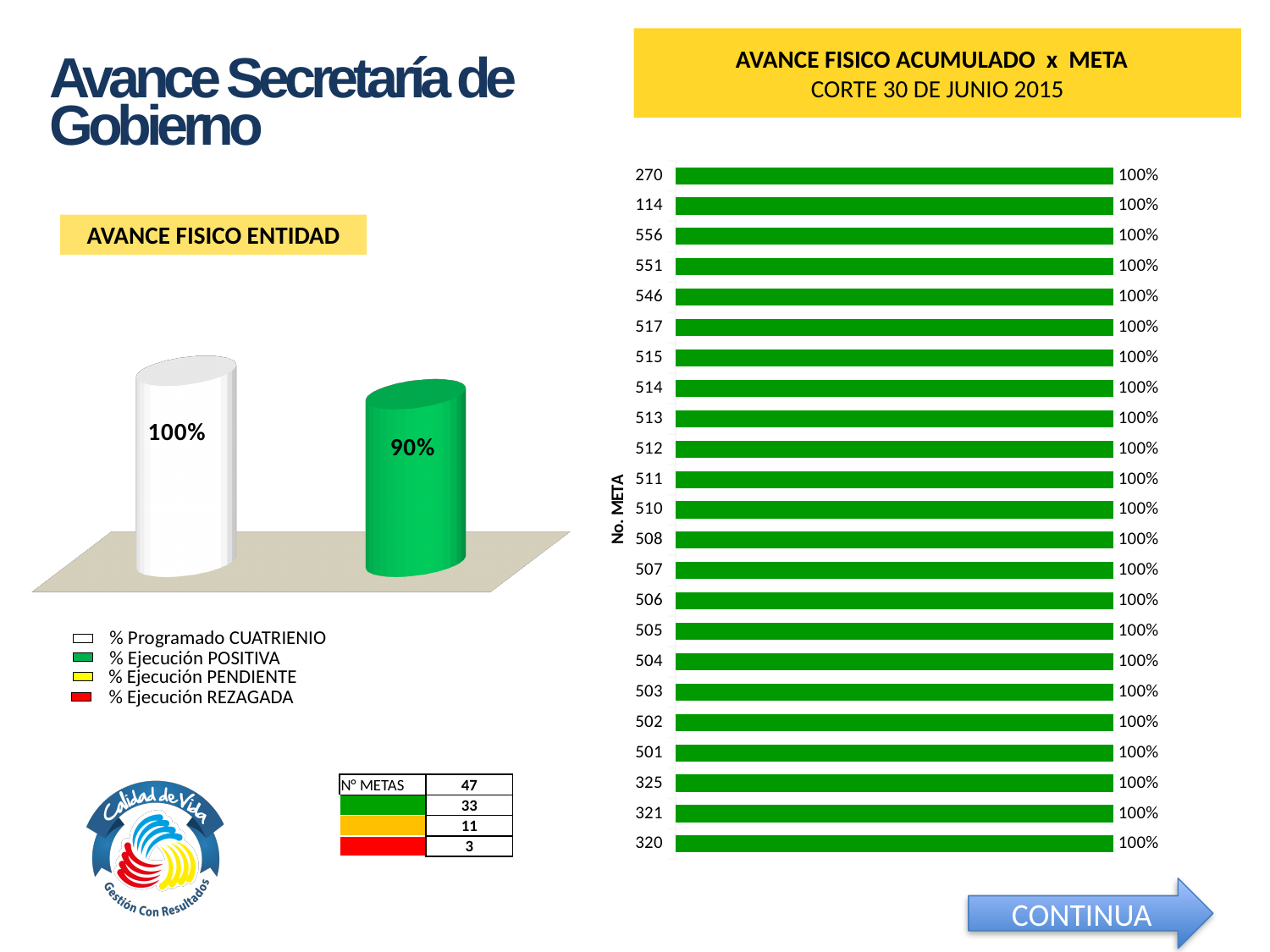
How many entries does the legend of the AVANCE FISICO ENTIDAD chart list? 4 In the AVANCE FISICO ENTIDAD chart, what is the value for % Ejecución POSITIVA? 90% What is the label of the vertical axis in the AVANCE FISICO ACUMULADO x META chart? No. META What kind of chart is the AVANCE FISICO ACUMULADO x META chart? Bar chart In the AVANCE FISICO ENTIDAD chart, what colour is the bar for % Ejecución POSITIVA? Green How many metas are plotted in the AVANCE FISICO ACUMULADO x META chart? 23 In the AVANCE FISICO ACUMULADO x META chart, what is the value for meta 320? 100% In the AVANCE FISICO ENTIDAD chart, which is larger, % Programado CUATRIENIO or % Ejecución POSITIVA? % Programado CUATRIENIO In the AVANCE FISICO ENTIDAD chart, what is the value for % Programado CUATRIENIO? 100% In the AVANCE FISICO ACUMULADO x META chart, what is the value for meta 556? 100% What kind of chart is the AVANCE FISICO ENTIDAD chart? Bar chart In the AVANCE FISICO ENTIDAD chart, what is the difference between % Programado CUATRIENIO and % Ejecución POSITIVA? 10%